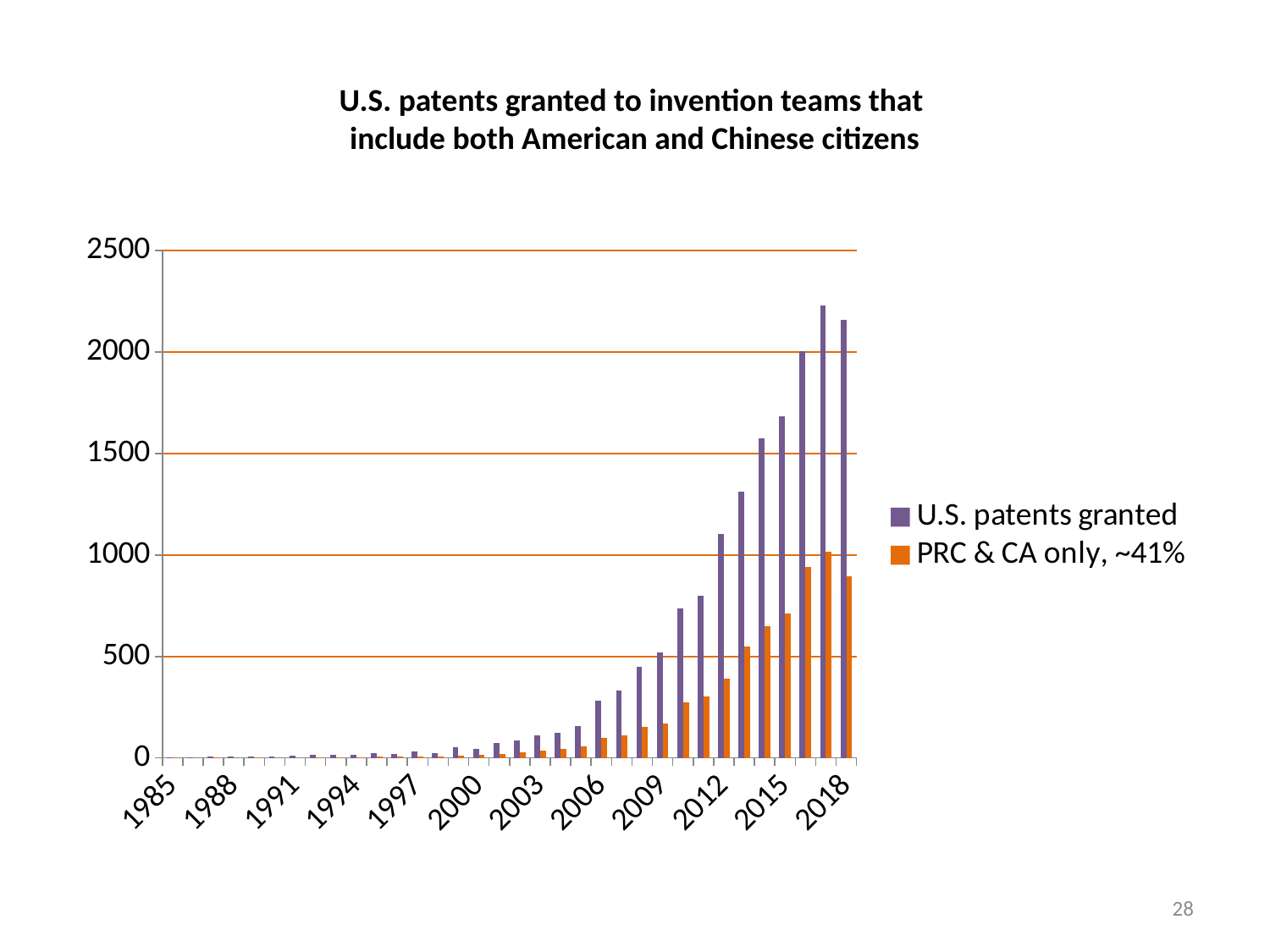
Is the value for U.S. patents granted in 2018 greater or less than 2000? greater Is the value for PRC & CA only in 2015 greater or less than 500? greater Is the value for U.S. patents granted in 2006 greater or less than 500? less What are the two series named in the legend? U.S. patents granted; PRC & CA only, ~41% What kind of chart is shown on the slide? bar chart What is the title of the chart? U.S. patents granted to invention teams that include both American and Chinese citizens How many years are plotted on the x axis, from 1985 to 2018? 34 In 2018, which series has the larger value, U.S. patents granted or PRC & CA only? U.S. patents granted Do the values for U.S. patents granted generally rise or fall from 1985 to 2018? rise How many series does the legend list? 2